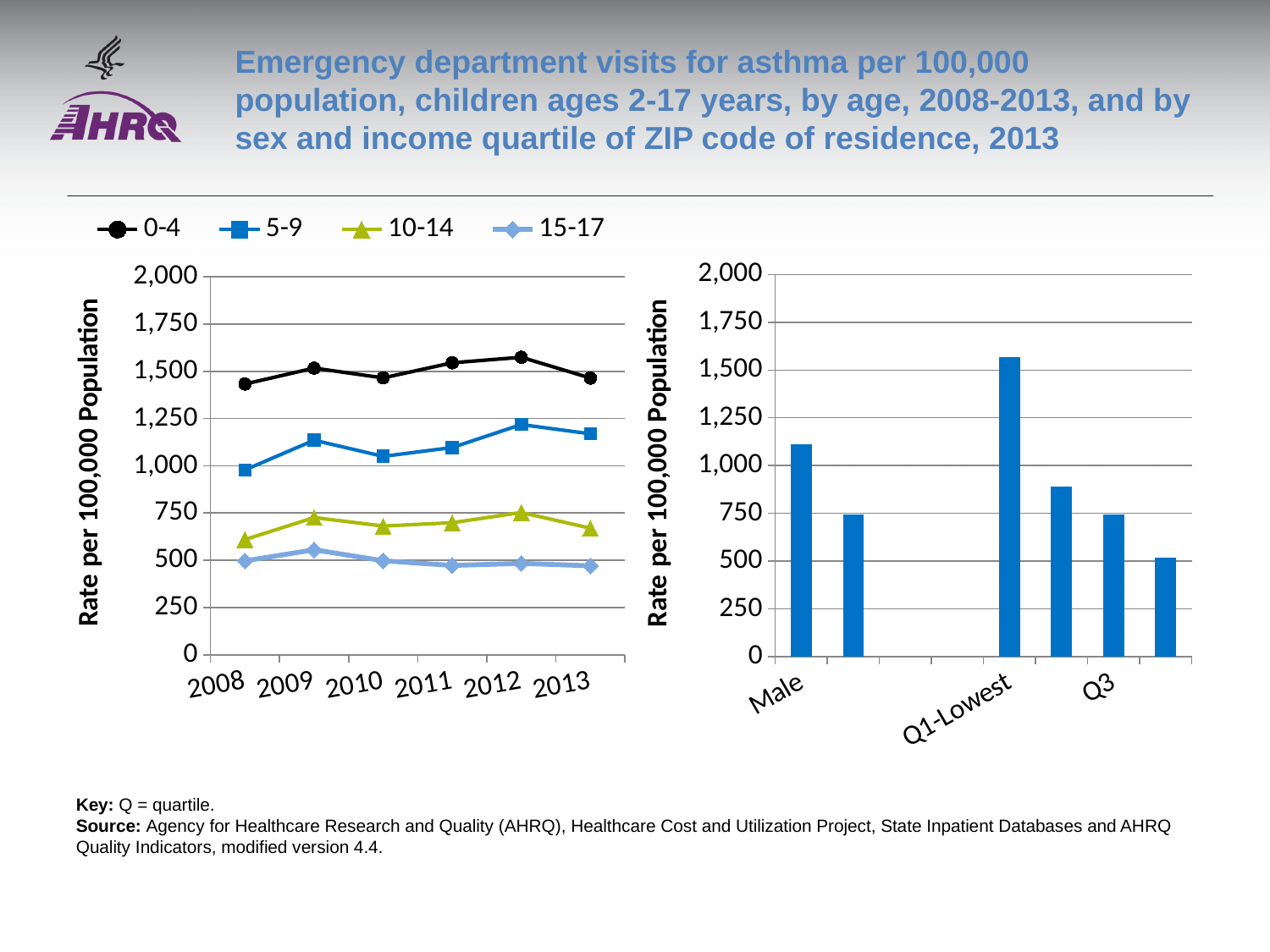
In the left chart, is the value for the 0-4 age group in 2012 greater or less than 1,500? greater In the left chart, how many age-group series does the legend list? 4 In the left chart, which age group has the highest rate across all years? 0-4 In the left chart, how many years are plotted along the x axis? 6 What is the y-axis title of the left chart? Rate per 100,000 Population In the left chart, is the value for the 10-14 age group in 2008 greater or less than 750? less In the right chart, is the value for Q1-Lowest greater or less than 1,500? greater In the left chart, which age group has the lowest rate across all years? 15-17 What kind of chart is the left chart showing rates by age group for 2008-2013? line chart In the right chart, which is larger, the value for Male or the value for Q3? Male In the left chart, does the 0-4 line rise or fall from 2010 to 2012? rise What kind of chart is the right chart showing rates by sex and income quartile for 2013? bar chart